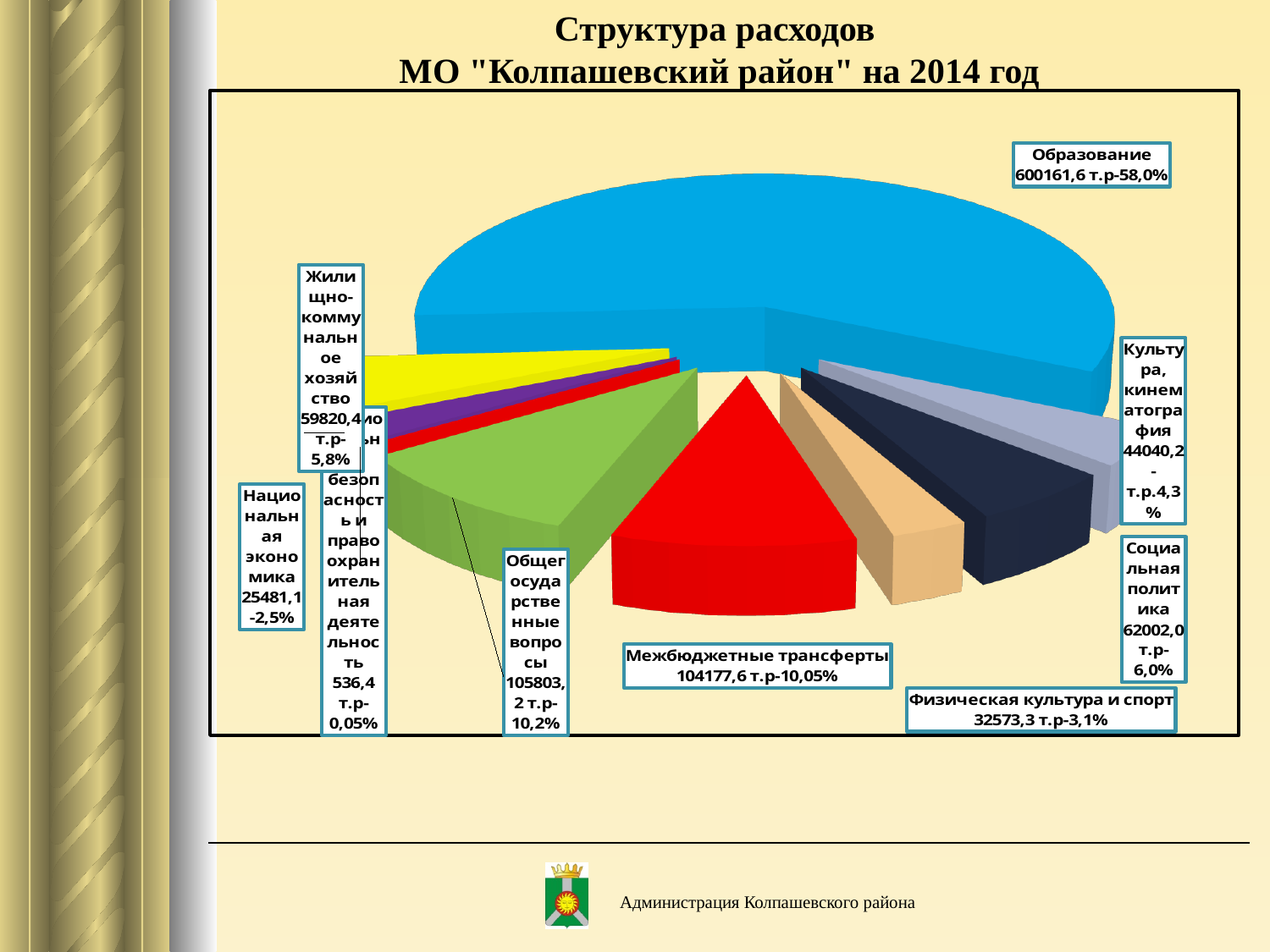
What is the value for Культура, кинематография in thousand rubles? 44040,2 т.р What is the difference in percentage share between Социальная политика and Жилищно-коммунальное хозяйство? 0,2% What kind of chart is shown on the slide? pie chart What share of expenditures does Образование account for? 58,0% Which is larger: Общегосударственные вопросы or Межбюджетные трансферты? Общегосударственные вопросы What is the value for Социальная политика? 62002,0 т.р What percentage share does Физическая культура и спорт have? 3,1% Which category has the smallest share of expenditures? Национальная безопасность и правоохранительная деятельность What is the title of the chart? Структура расходов МО "Колпашевский район" на 2014 год What is the value for Межбюджетные трансферты in thousand rubles? 104177,6 т.р Which category has the largest share of expenditures? Образование How many categories are shown in the pie chart? 9